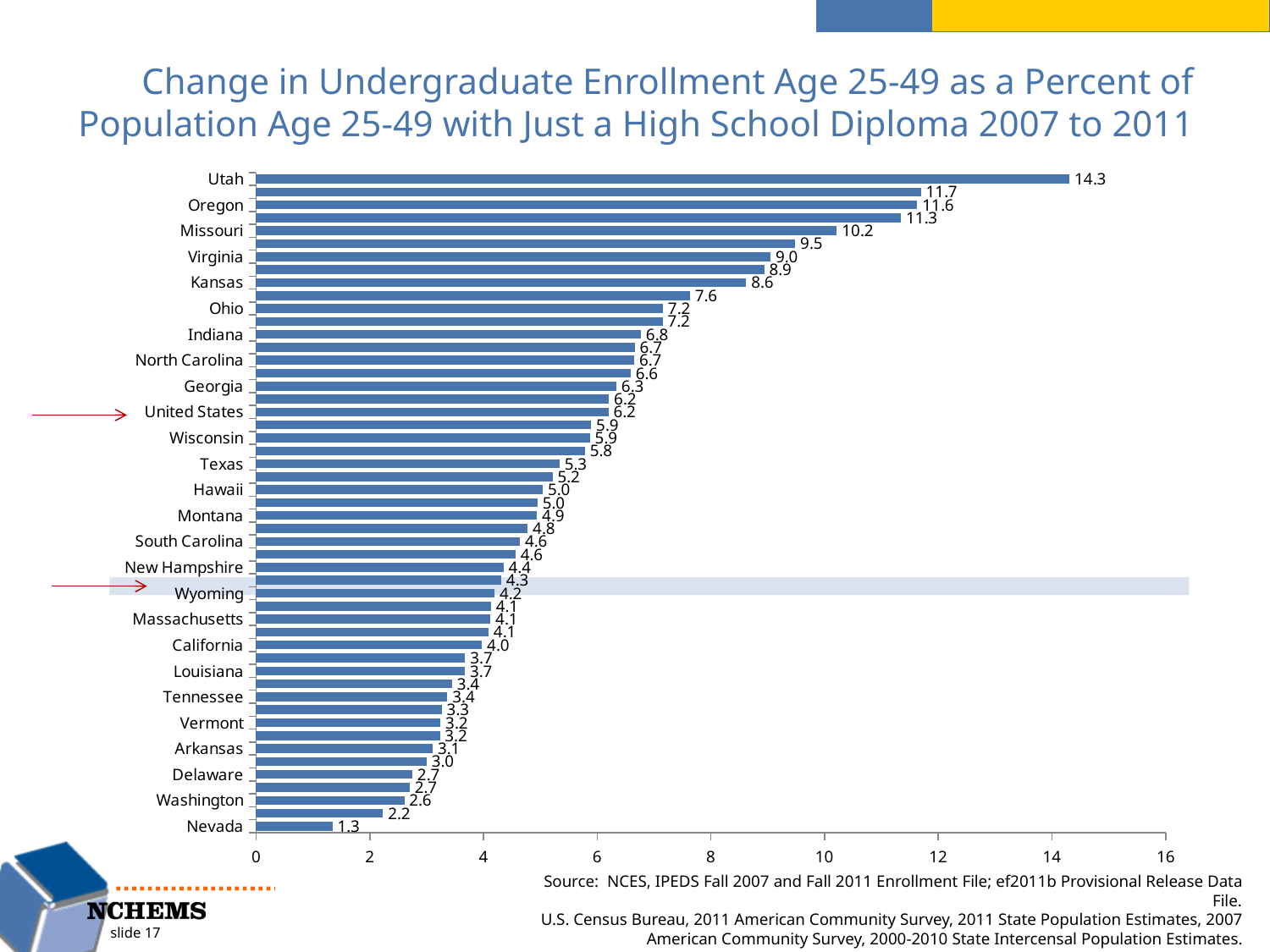
What is the value shown for Utah? 14.3 Which state has the lowest value on the chart? Nevada Which state has the highest value on the chart? Utah What is the difference between the values for Utah and Nevada? 13.0 What is the value shown for Nevada? 1.3 Is the value for Kansas greater or less than 8? greater Which has a larger value, Utah or Missouri? Utah Do the bar values increase or decrease going from the top of the chart to the bottom? Decrease What kind of chart is shown on the slide? Bar chart Which row of the chart is highlighted with a shaded band? Wyoming What is the value shown for Wyoming? 4.2 What is the value shown for the United States? 6.2